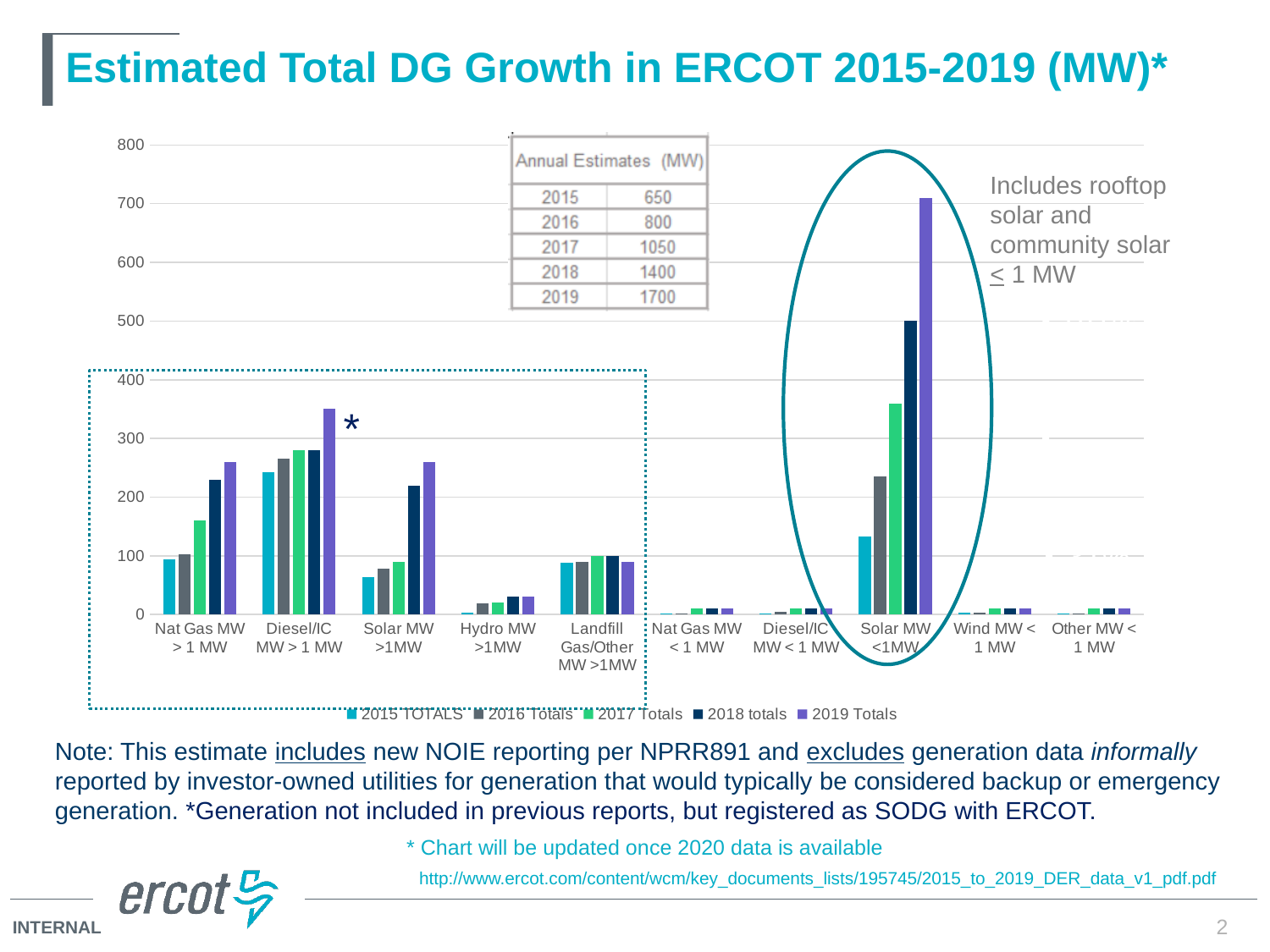
How many series does the chart legend list? 5 Which series is shown in purple in the chart legend? 2019 Totals How many categories are shown along the x axis of the chart? 10 Do the values for Solar MW <1MW rise or fall from 2015 to 2019? rise Which category has the tallest bar in the chart? Solar MW <1MW For 2019 Totals, which is larger: Diesel/IC MW > 1 MW or Nat Gas MW > 1 MW? Diesel/IC MW > 1 MW Is the 2019 Totals value for Diesel/IC MW > 1 MW greater or less than 300? greater Is the 2015 TOTALS value for Nat Gas MW > 1 MW greater or less than 100? less Is the 2018 totals value for Solar MW >1MW greater or less than 200? greater What kind of chart is shown on the slide? bar chart What is the title of the chart on the slide? Estimated Total DG Growth in ERCOT 2015-2019 (MW)*